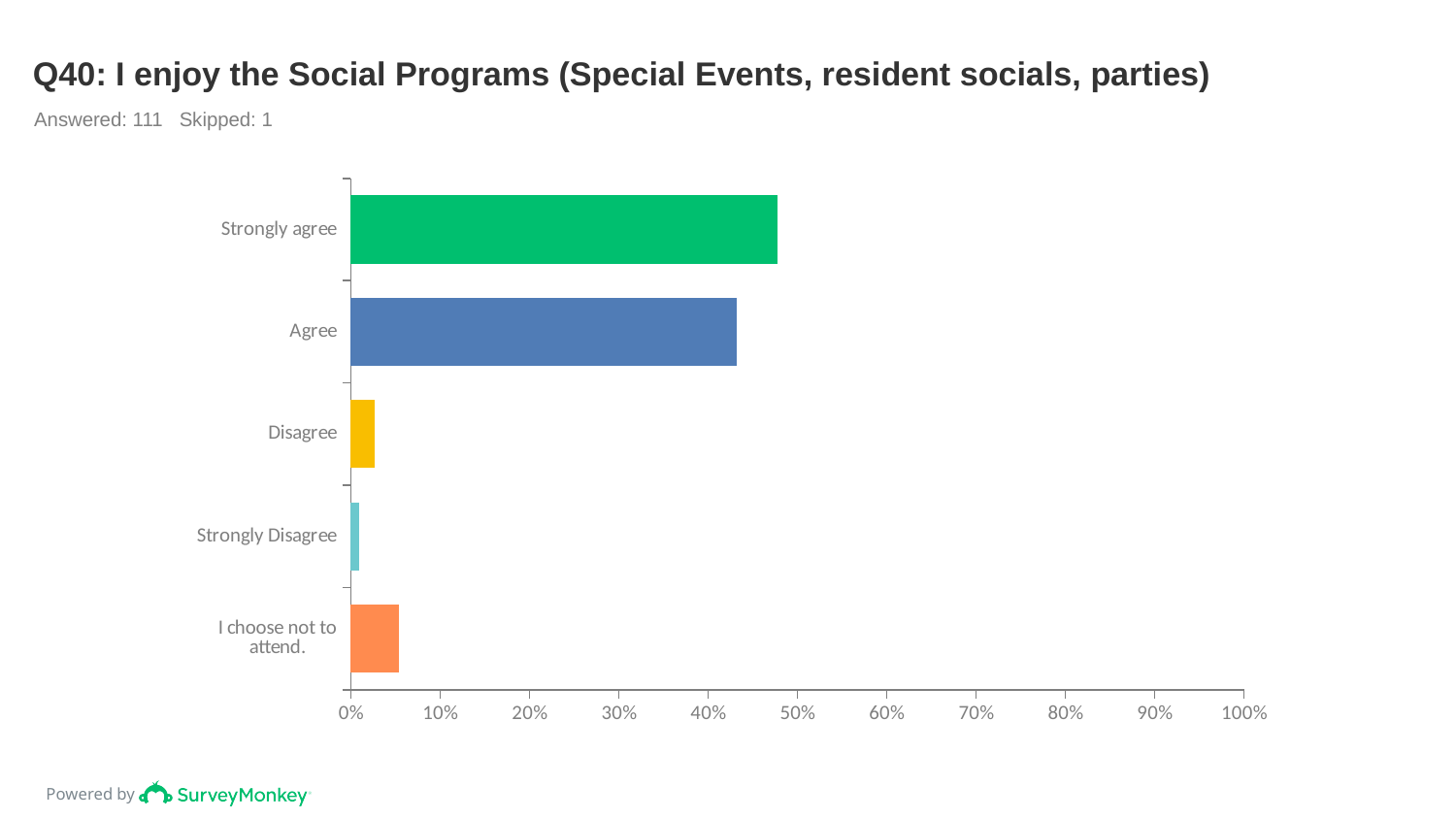
What is the maximum value shown on the horizontal axis? 100% Which is larger, the value for Disagree or the value for I choose not to attend? I choose not to attend. Is the value for Disagree greater or less than 10%? less Is the value for Agree greater or less than 50%? less What kind of chart is shown on the slide? Bar chart Which is larger, the value for Strongly agree or the value for Agree? Strongly agree Which response category has the lowest value? Strongly Disagree How many respondents answered this question according to the slide? 111 Which response category has the highest value? Strongly agree Is the value for I choose not to attend greater or less than 10%? less How many response categories are plotted in the chart? 5